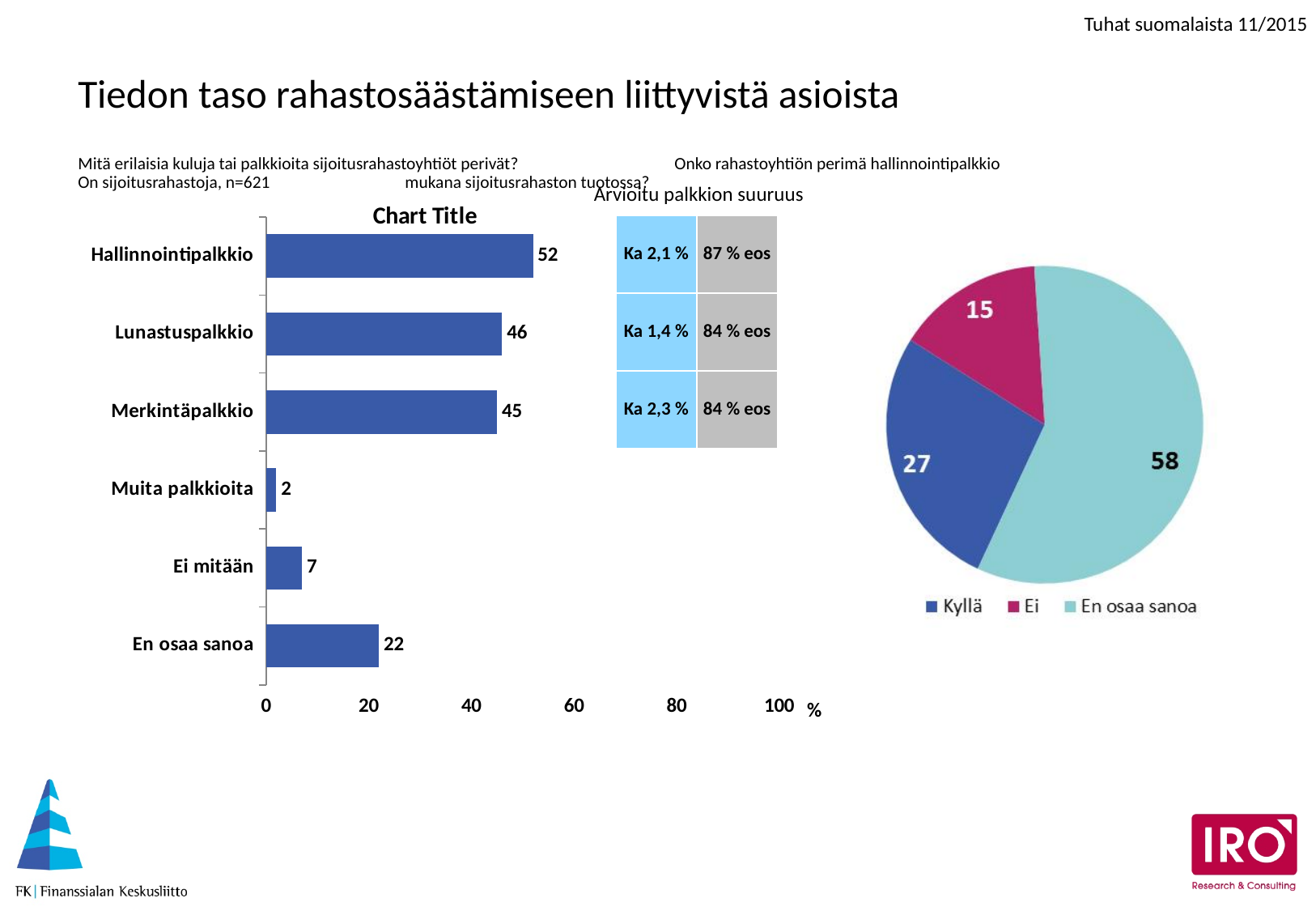
In the bar chart on the left, what is the value for Lunastuspalkkio? 46 In the bar chart on the left, what is the value for En osaa sanoa? 22 How many entries does the legend of the pie chart on the right list? 3 In the bar chart on the left, what is the difference between the values for Hallinnointipalkkio and Merkintäpalkkio? 7 In the pie chart on the right, what is the difference between the values for En osaa sanoa and Kyllä? 31 How many categories does the bar chart on the left show? 6 In the bar chart on the left, which category has the lowest value? Muita palkkioita In the bar chart on the left, which category has the highest value? Hallinnointipalkkio In the pie chart on the right, which slice is the largest? En osaa sanoa In the bar chart on the left, which is larger: the value for Ei mitään or the value for En osaa sanoa? En osaa sanoa What kind of chart is the chart on the left of the slide? Bar chart In the pie chart on the right, what is the value for Ei? 15